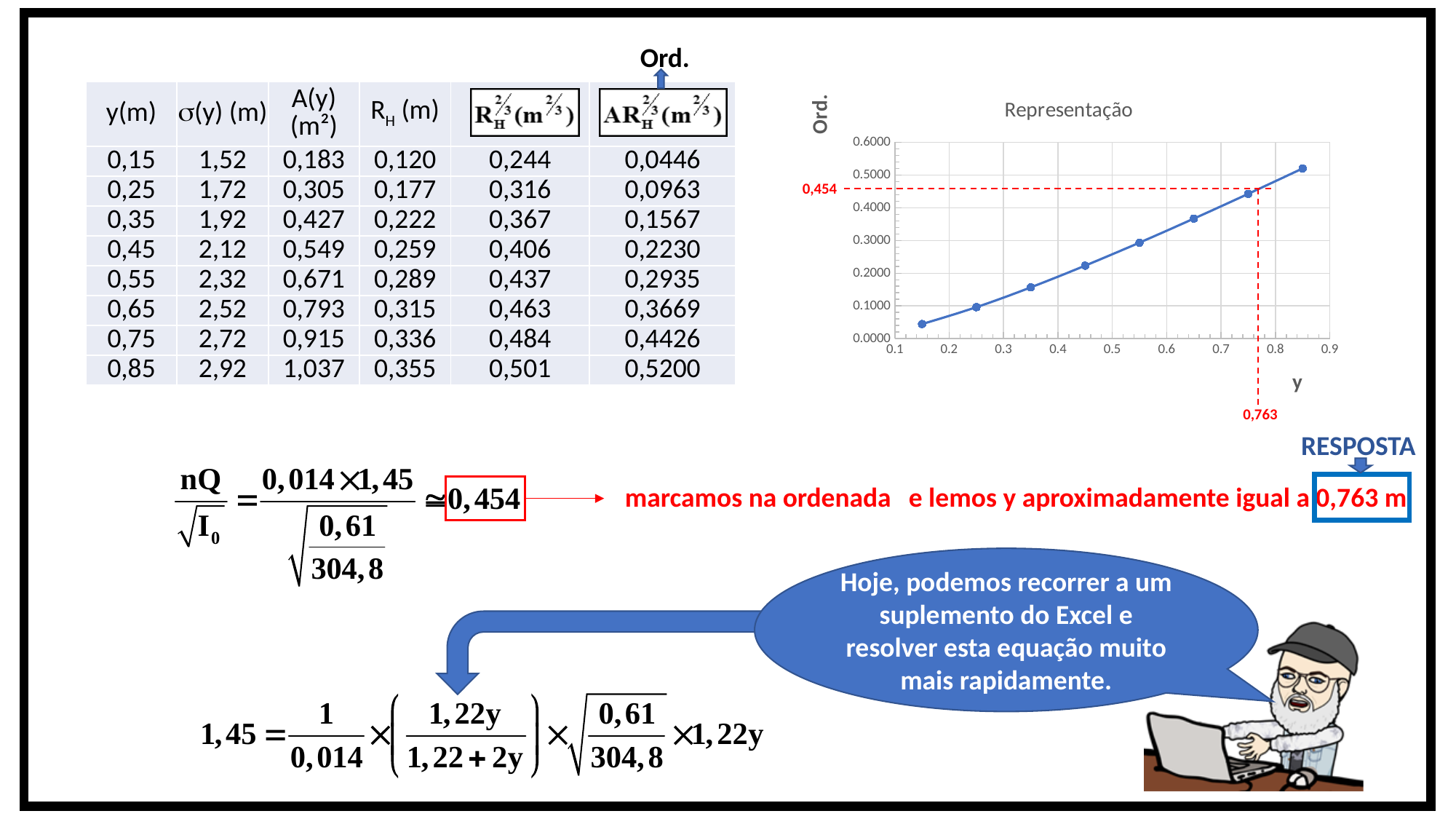
Is the plotted value at y = 0.15 greater or less than 0.1000? less Is the plotted value at y = 0.85 greater or less than 0.5000? greater Which has the larger plotted value: y = 0.35 or y = 0.75? y = 0.75 At which value of y is the plotted ordinate lowest? 0.15 At which value of y is the plotted ordinate highest? 0.85 What kind of chart is shown on the slide? line chart How many data points are plotted on the chart? 8 Is the plotted value at y = 0.45 greater or less than 0.2000? greater What ordinate value is marked by the red dashed line on the chart? 0,454 What is the title of the chart on the slide? Representação Do the plotted values rise or fall as y increases along the x axis? rise